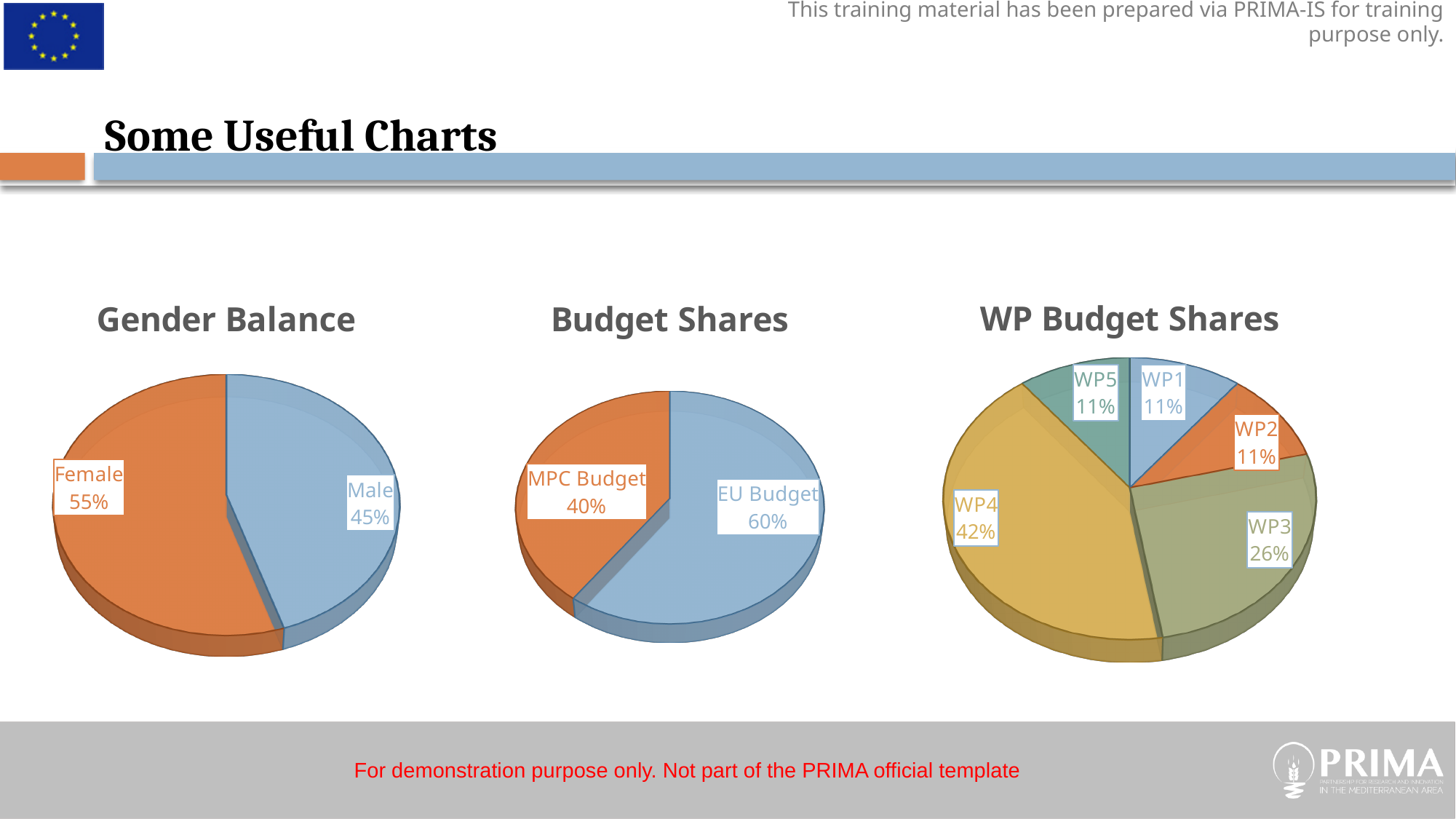
In the Budget Shares chart, what is the difference between EU Budget and MPC Budget? 20% In the WP Budget Shares chart, what share is WP4? 42% In the WP Budget Shares chart, what share is WP3? 26% In the Gender Balance chart, which slice is larger, Female or Male? Female In the WP Budget Shares chart, which work package has the largest share? WP4 In the Budget Shares chart, what share is MPC Budget? 40% In the Gender Balance chart, what share is Male? 45% What kind of chart is the Budget Shares chart? Pie chart How many charts are shown on the slide? 3 In the Gender Balance chart, what share is Female? 55% In the WP Budget Shares chart, how many slices are there? 5 In the Budget Shares chart, what share is EU Budget? 60%